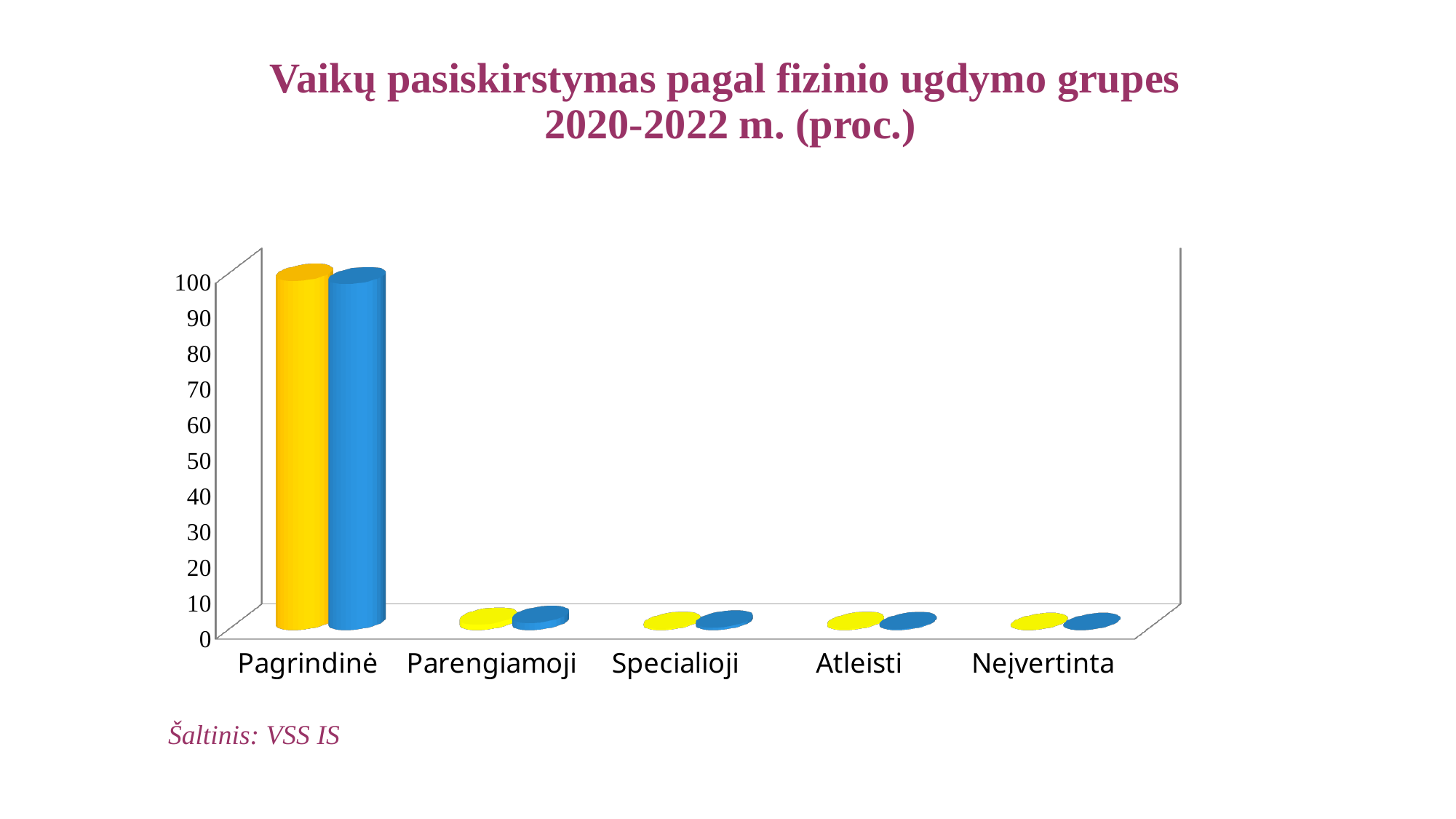
Which category has a larger yellow bar: Pagrindinė or Neįvertinta? Pagrindinė Is the value of the yellow bar for Parengiamoji greater or less than 10? less Is the value of the yellow bar for Pagrindinė greater or less than 90? greater Which category has a larger value: Pagrindinė or Specialioji? Pagrindinė Is the value of the blue bar for Pagrindinė greater or less than 50? greater How many categories are shown on the x axis of the chart? 5 What kind of chart is shown on the slide? bar chart Which category has the highest values in the chart? Pagrindinė What source is cited below the chart? VSS IS What is the title of the chart? Vaikų pasiskirstymas pagal fizinio ugdymo grupes 2020-2022 m. (proc.)